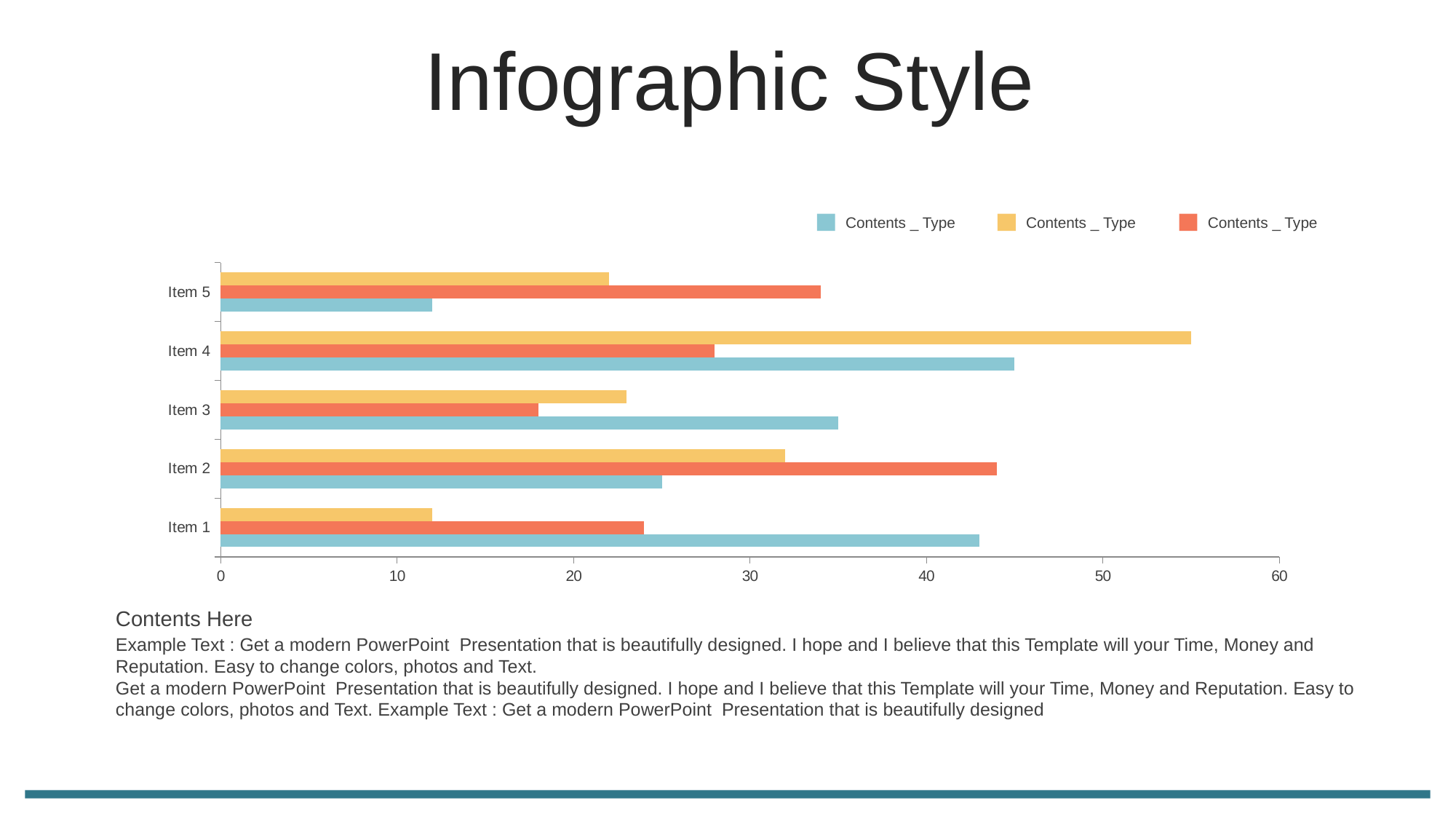
Is the value of the orange bar for Item 2 greater or less than 40? greater What kind of chart is shown on the slide? bar chart Is the value of the yellow bar for Item 4 greater or less than 50? greater How many categories (items) are plotted on the chart? 5 Which item has the longest blue bar? Item 4 What is the highest value shown on the horizontal axis? 60 Is the value of the blue bar for Item 5 greater or less than 20? less Which item has the shortest yellow bar? Item 1 How many series does the chart legend list? 3 For Item 5, which bar is longer: the orange bar or the yellow bar? the orange bar For Item 3, which bar is longer: the blue bar or the orange bar? the blue bar